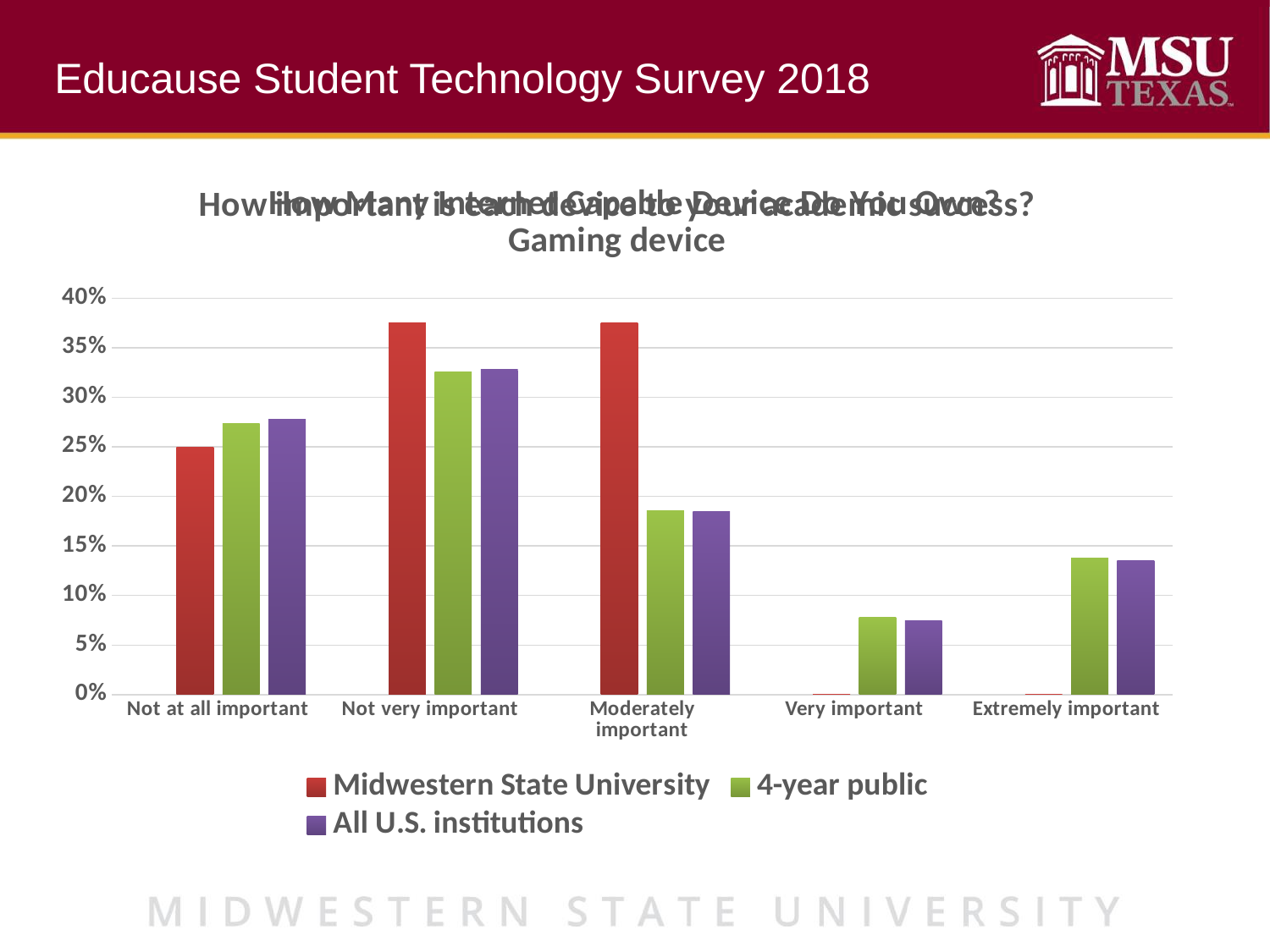
Is the value for 4-year public in the 'Very important' category greater or less than 10%? less Which device does the chart's subtitle say the data is about? Gaming device Is the value for All U.S. institutions in the 'Extremely important' category greater or less than 15%? less Which category has the lowest value for the All U.S. institutions series? Very important In the 'Moderately important' category, which is larger: Midwestern State University or 4-year public? Midwestern State University How many series does the legend list? 3 Which category has the highest value for the 4-year public series? Not very important In the 'Not at all important' category, which is larger: Midwestern State University or 4-year public? 4-year public Is the value for Midwestern State University in the 'Not very important' category greater or less than 35%? greater What is the value for Midwestern State University in the 'Very important' category? 0% How many categories are shown along the x axis? 5 What kind of chart is shown on the slide? bar chart